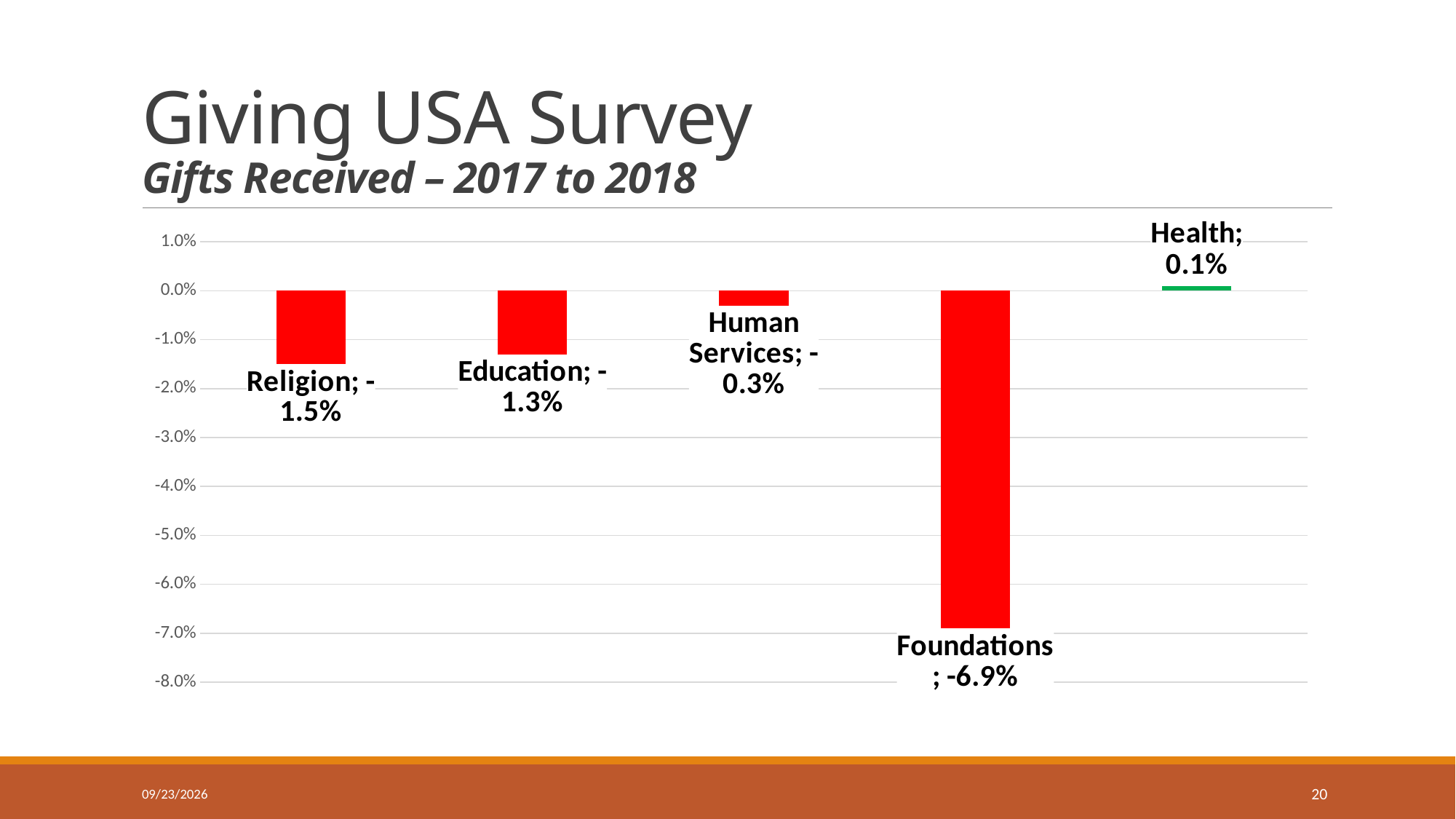
What is the value for Religion? -1.5% Which category has the highest value? Health How many categories are shown in the chart? 5 What is the value for Education? -1.3% Which category has the lowest value? Foundations Which is larger, the value for Education or the value for Foundations? Education What is the value for Health? 0.1% What is the value for Human Services? -0.3% What is the difference between the values for Foundations and Human Services? 6.6% What is the difference between the values for Religion and Education? 0.2% What is the value for Foundations? -6.9% What kind of chart is shown on the slide? Bar chart